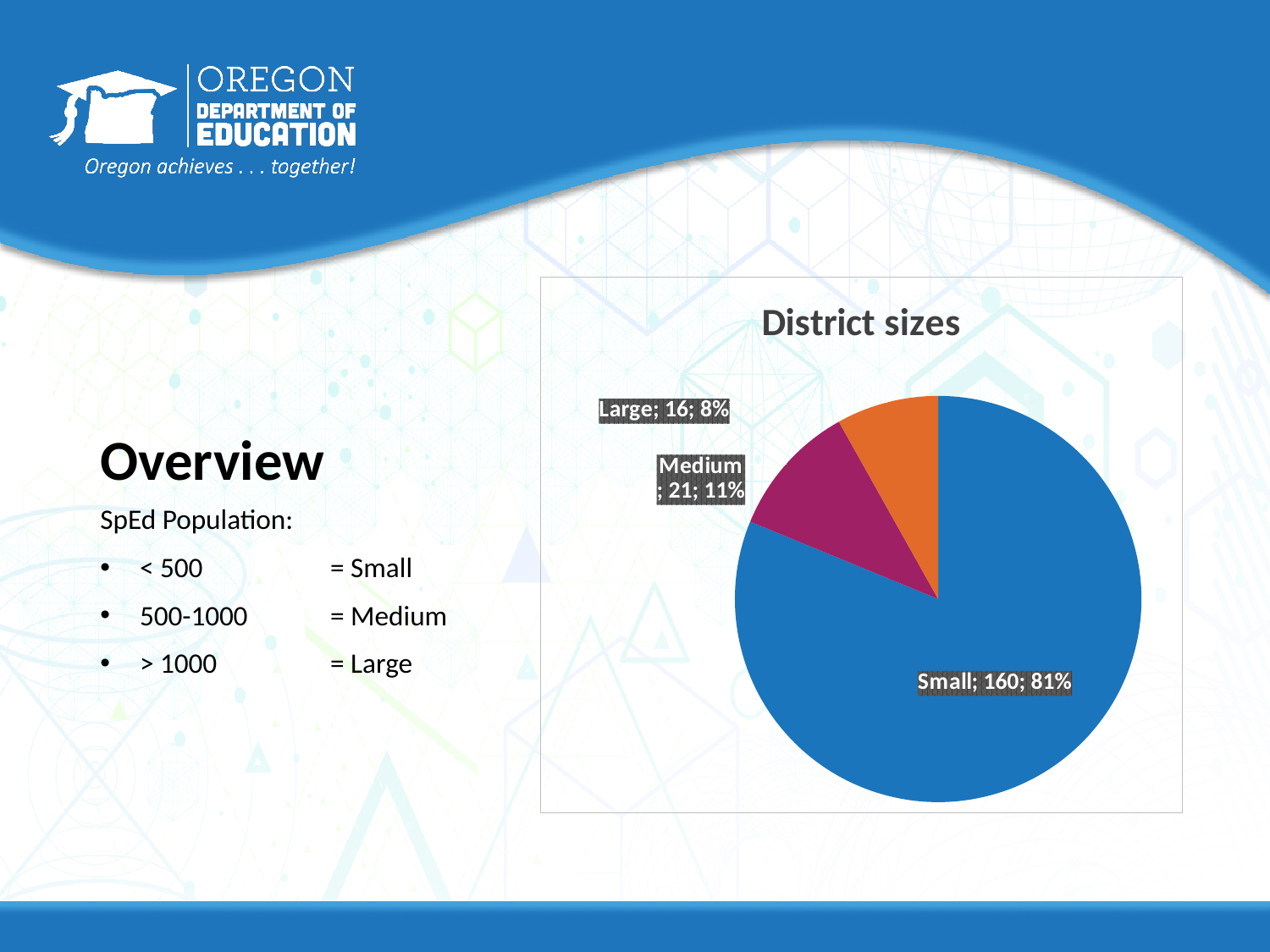
What is the value for Medium in the pie chart? 21 What is the value for Large in the pie chart? 16 Which category has the smallest slice in the pie chart? Large Which category has the largest slice in the pie chart? Small What kind of chart is shown on the slide? pie chart Which is larger, the value for Medium or the value for Large? Medium What is the value for Small in the pie chart? 160 What is the difference between the values for Small and Medium? 139 What share of the pie does the Small slice represent? 81% What is the title of the chart? District sizes How many slices does the pie chart have? 3 What share of the pie does the Medium slice represent? 11%